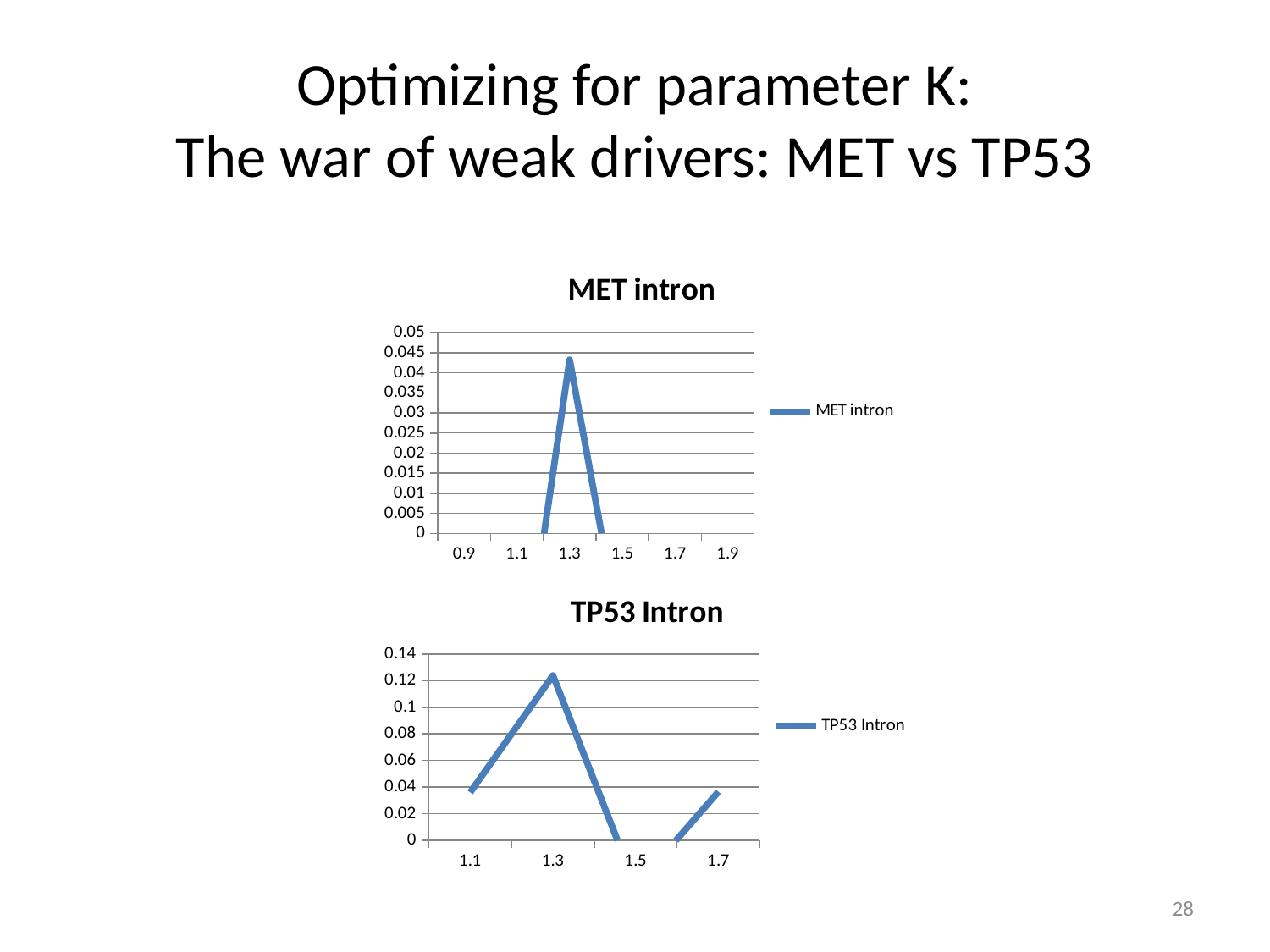
How many series does the legend of the TP53 Intron chart list? 1 What kind of chart is the TP53 Intron chart? line chart What is the legend entry shown on the MET intron chart? MET intron In the MET intron chart, is the peak value at 1.3 greater or less than 0.03? greater In the MET intron chart, at which x-axis value does the line reach its highest point? 1.3 In the TP53 Intron chart, at which x-axis value does the line reach its highest point? 1.3 In the TP53 Intron chart, is the value at 1.3 greater or less than 0.1? greater In the MET intron chart, is the peak value at 1.3 greater or less than 0.05? less In the TP53 Intron chart, which has the larger value: 1.1 or 1.3? 1.3 In the TP53 Intron chart, does the line rise or fall between 1.3 and 1.5? fall What kind of chart is the MET intron chart? line chart